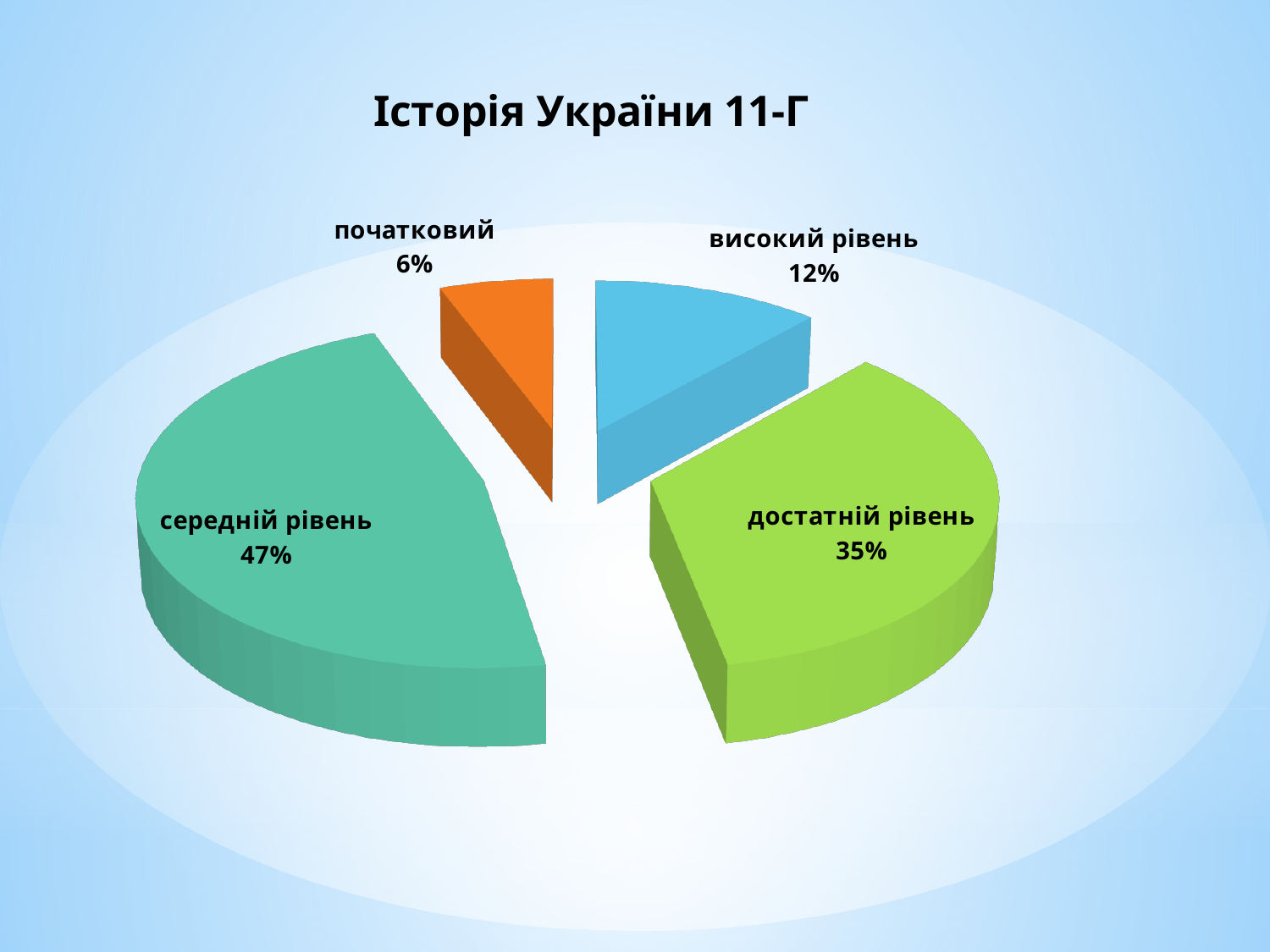
What is the difference between the shares of середній рівень and достатній рівень? 12% What is the share for середній рівень? 47% What is the share for достатній рівень? 35% How many slices does the pie chart have? 4 What colour is the slice for достатній рівень? green Which is larger, the share for високий рівень or the share for початковий? високий рівень What is the share for високий рівень? 12% What kind of chart is shown on the slide? pie chart What is the title of the chart? Історія України 11-Г What is the share for початковий? 6% Which category has the largest share? середній рівень Which category has the smallest share? початковий